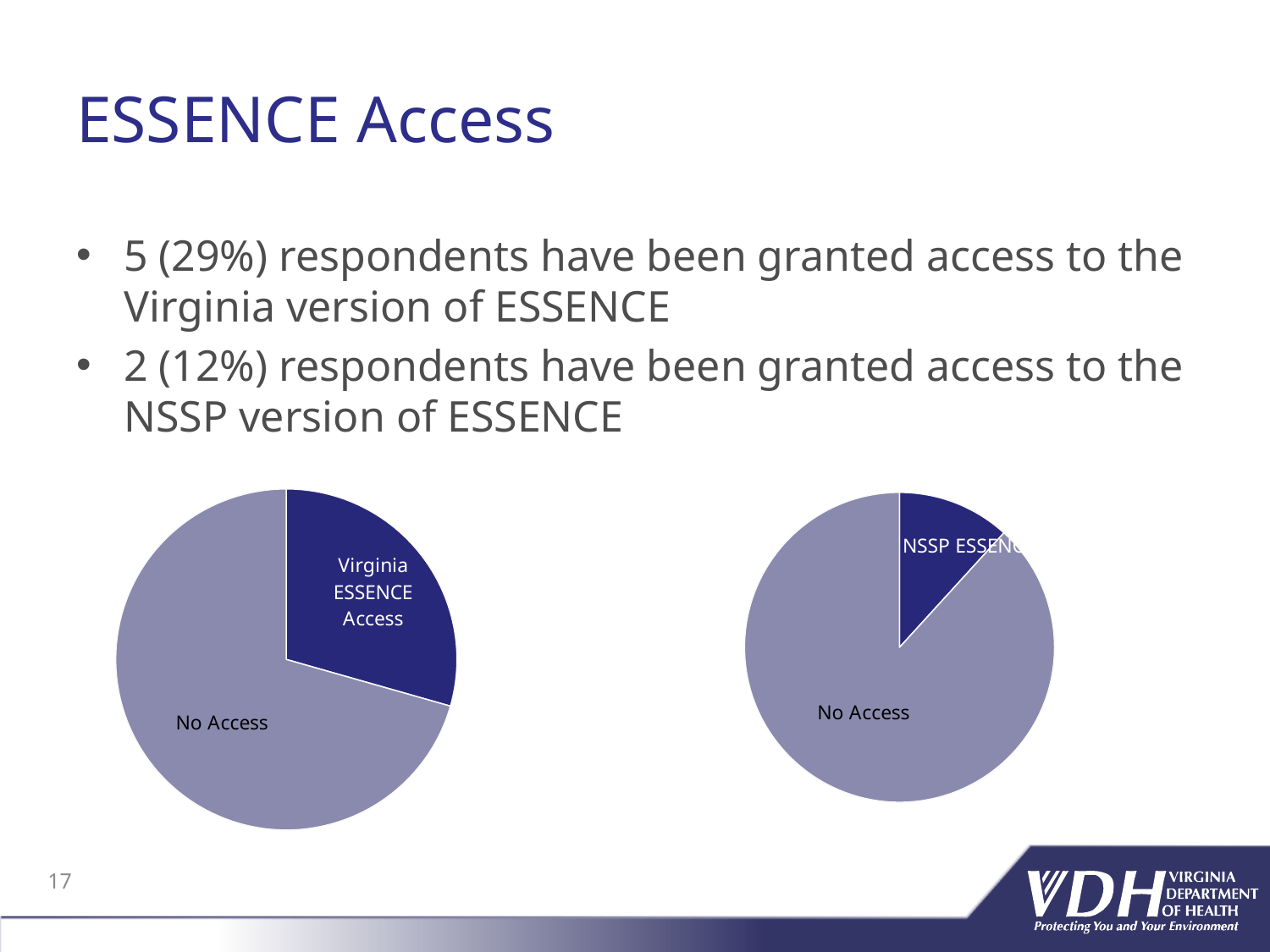
What kind of chart is the right chart on the slide? Pie chart Is the access slice larger in the left pie chart (Virginia ESSENCE) or the right pie chart (NSSP ESSENCE)? The left pie chart In the left pie chart, which slice is the largest? No Access What kind of chart is the left chart on the slide? Pie chart How many slices does the right pie chart have? 2 In the right pie chart, which slice is the largest? No Access In the left pie chart, which is larger: the No Access slice or the Virginia ESSENCE Access slice? No Access In the right pie chart, which slice is the smallest? NSSP ESSENCE In the left pie chart, which slice is the smallest? Virginia ESSENCE Access How many slices does the left pie chart have? 2 According to the slide text, what share of respondents does the Virginia ESSENCE Access slice in the left pie chart represent? 29% In the left pie chart, which slice is coloured dark blue? Virginia ESSENCE Access